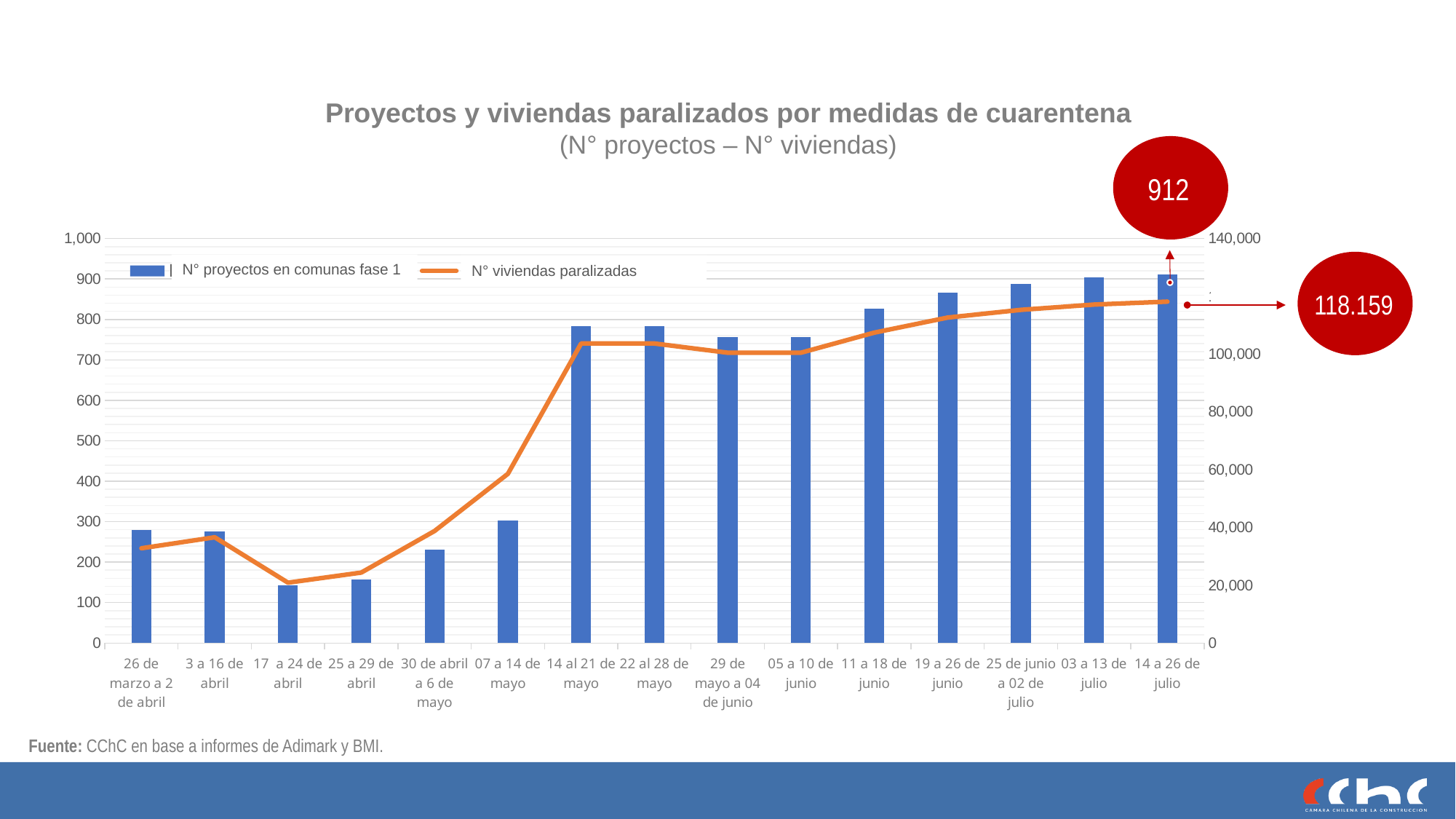
How many time periods are shown on the x axis of the chart? 15 Is the bar for N° proyectos en comunas fase 1 in the period 17 a 24 de abril greater or less than 200? less What is the value of N° viviendas paralizadas for the period 14 a 26 de julio? 118.159 Which period has the highest number of N° proyectos en comunas fase 1? 14 a 26 de julio Is the bar for N° proyectos en comunas fase 1 in the period 14 al 21 de mayo greater or less than 700? greater What is the title of the chart? Proyectos y viviendas paralizados por medidas de cuarentena Does the N° viviendas paralizadas line generally rise or fall from the first period to the last period? Rise Is the value of N° viviendas paralizadas for the period 07 a 14 de mayo greater or less than 40,000? greater What is the value of N° proyectos en comunas fase 1 for the period 14 a 26 de julio? 912 How many series does the chart's legend list? 2 What kind of chart is shown on the slide? Combined bar and line chart Which period has more N° proyectos en comunas fase 1: 3 a 16 de abril or 30 de abril a 6 de mayo? 3 a 16 de abril